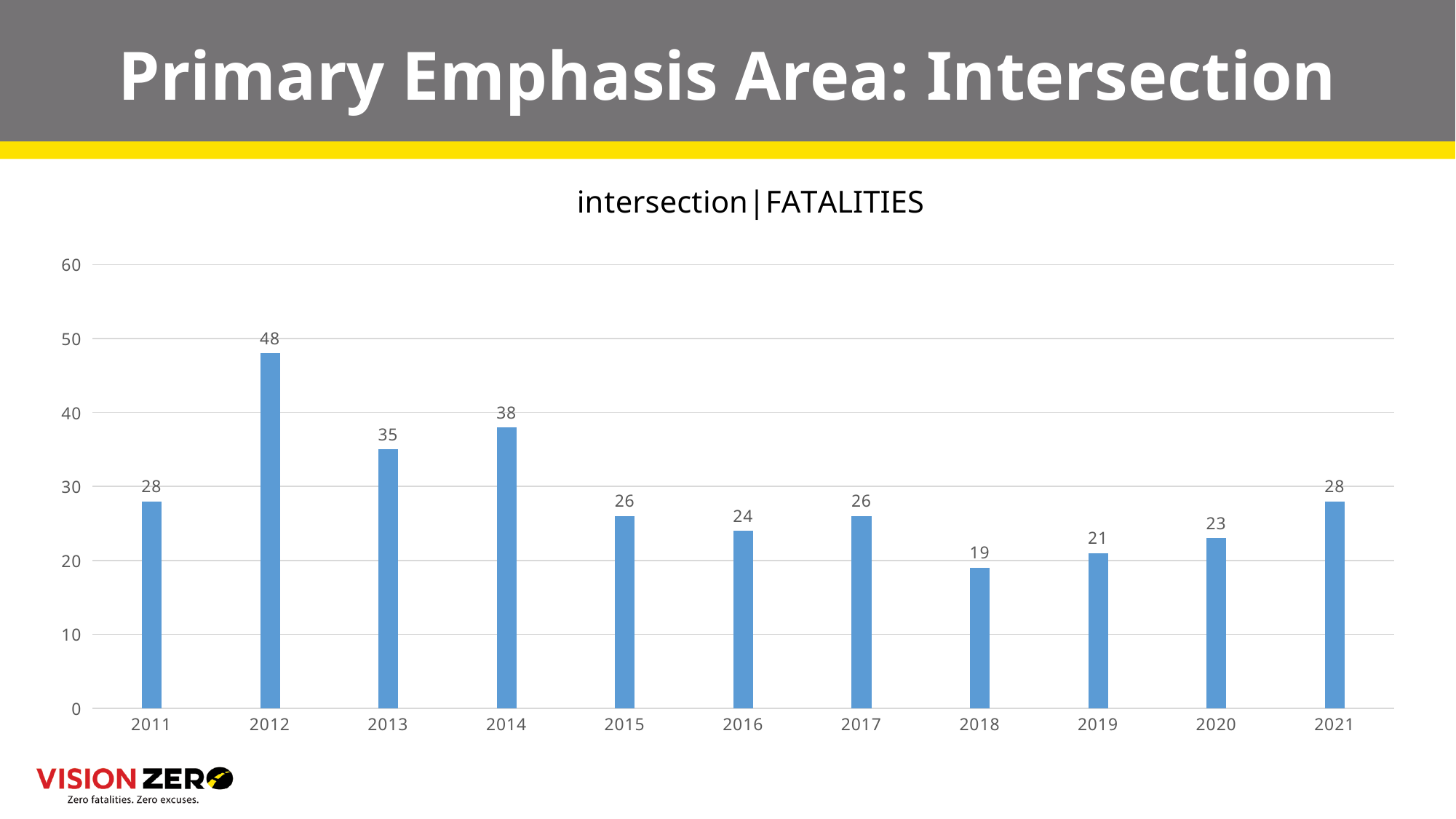
What is the difference between the values for 2012 and 2013? 13 What is the difference between the values for 2014 and 2021? 10 Which is larger, the value for 2016 or the value for 2019? 2016 What is the value for 2020? 23 What is the value for 2012? 48 How many years are shown on the x axis? 11 What is the title of the chart? intersection|FATALITIES Which year has the highest value? 2012 What kind of chart is this? bar chart What is the value for 2018? 19 Which year has the lowest value? 2018 Is the value for 2014 greater or less than 30? greater